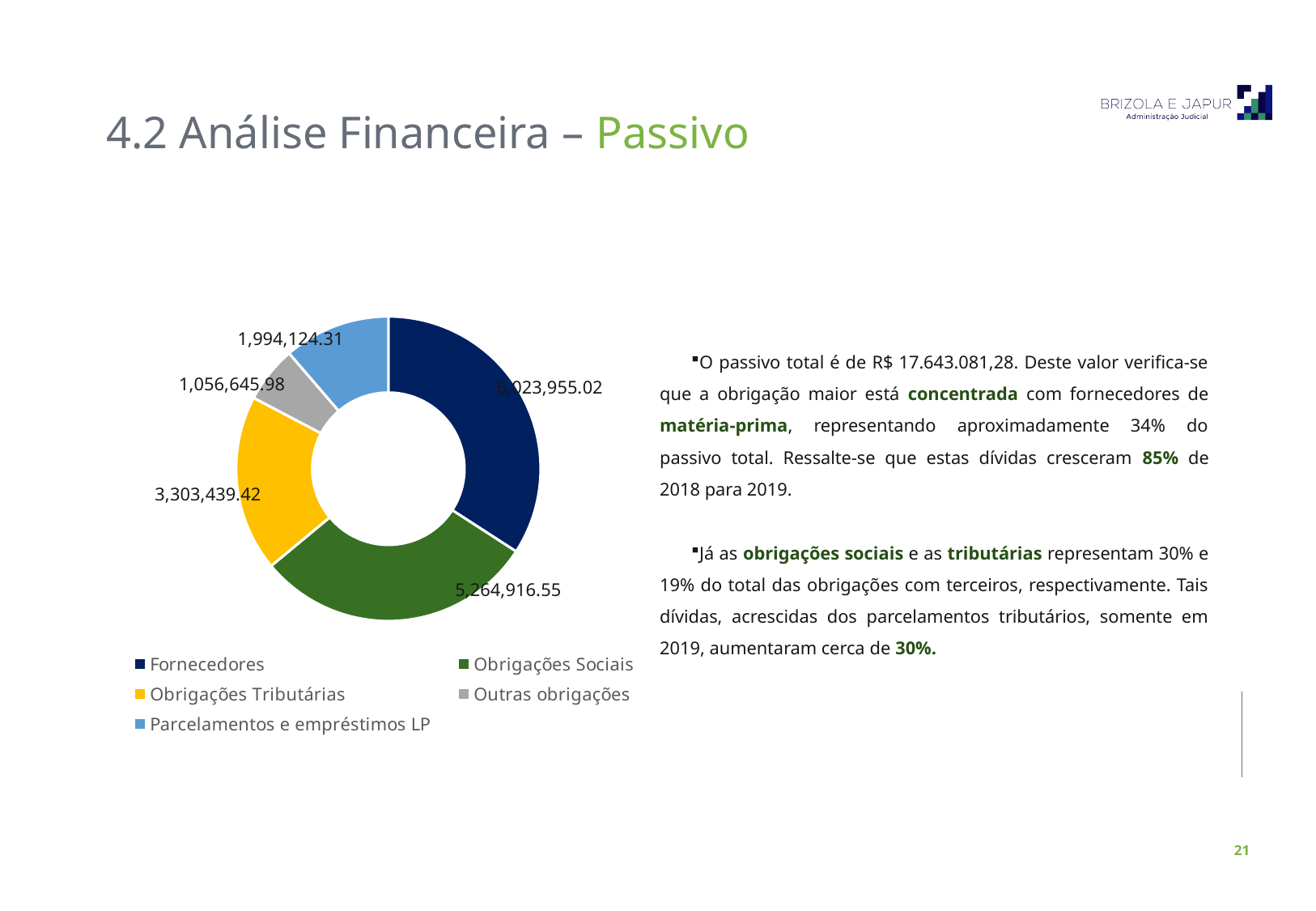
Which category has the largest value in the chart? Fornecedores What is the value for Obrigações Sociais in the chart? 5,264,916.55 Which category has the smallest value in the chart? Outras obrigações Which colour represents Obrigações Tributárias in the chart? Yellow What is the value for Parcelamentos e empréstimos LP in the chart? 1,994,124.31 Which is larger, the value for Parcelamentos e empréstimos LP or the value for Outras obrigações? Parcelamentos e empréstimos LP What is the difference between the values for Fornecedores and Obrigações Sociais? 759,038.47 How many entries does the chart legend list? 5 What type of chart is shown on the slide? Doughnut (pie) chart What is the value for Obrigações Tributárias in the chart? 3,303,439.42 What is the value for Fornecedores in the chart? 6,023,955.02 How many categories does the doughnut chart show? 5